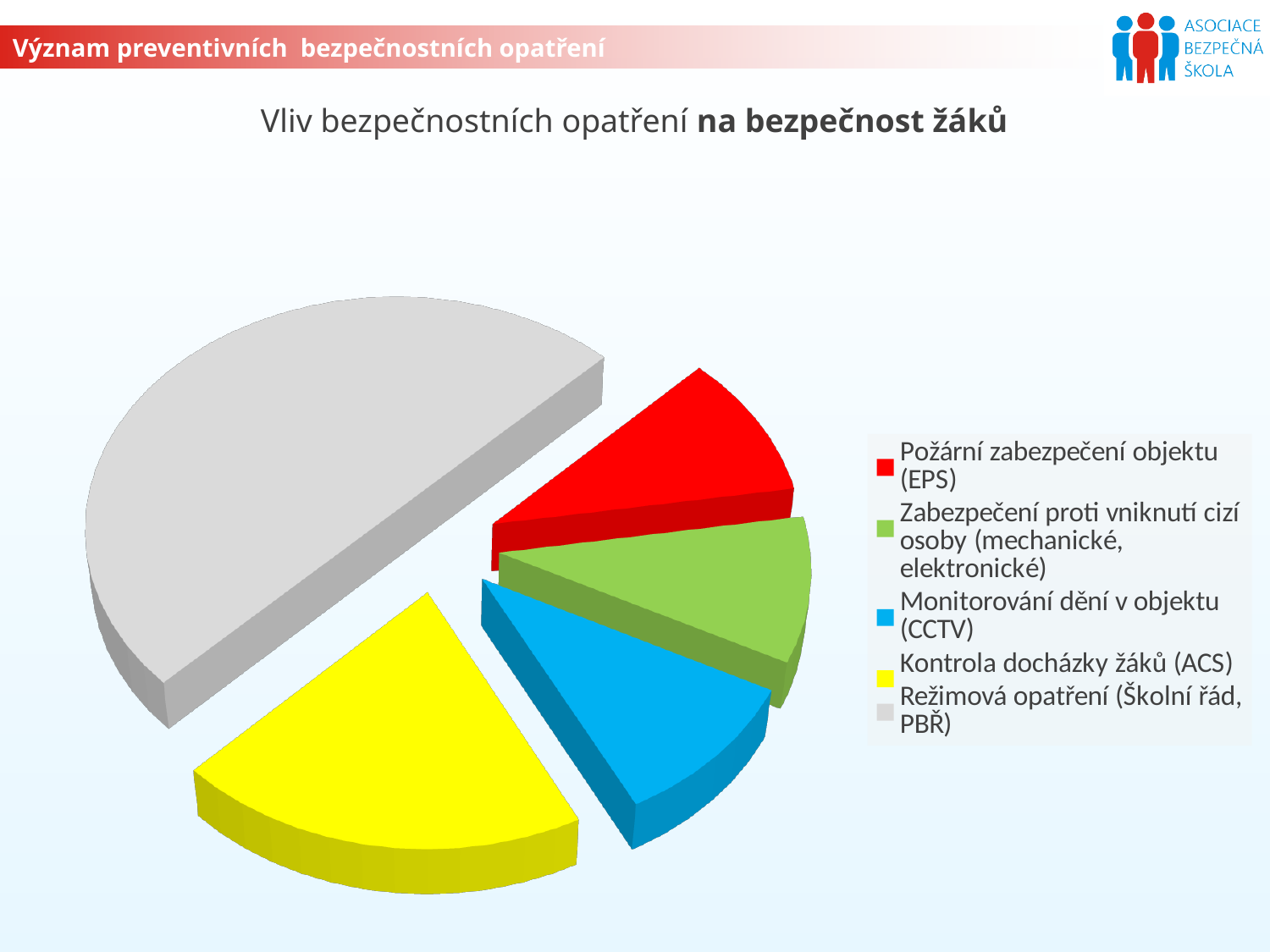
Which slice is larger: Režimová opatření (Školní řád, PBŘ) or Kontrola docházky žáků (ACS)? Režimová opatření (Školní řád, PBŘ) What kind of chart is shown on the slide? pie chart Which slice is larger: Kontrola docházky žáků (ACS) or Monitorování dění v objektu (CCTV)? Kontrola docházky žáků (ACS) Which slice is larger: Režimová opatření (Školní řád, PBŘ) or Zabezpečení proti vniknutí cizí osoby (mechanické, elektronické)? Režimová opatření (Školní řád, PBŘ) Which category has the largest slice of the pie chart? Režimová opatření (Školní řád, PBŘ) What is the title of the chart? Vliv bezpečnostních opatření na bezpečnost žáků How many categories does the pie chart have? 5 What colour is the slice for Monitorování dění v objektu (CCTV)? blue